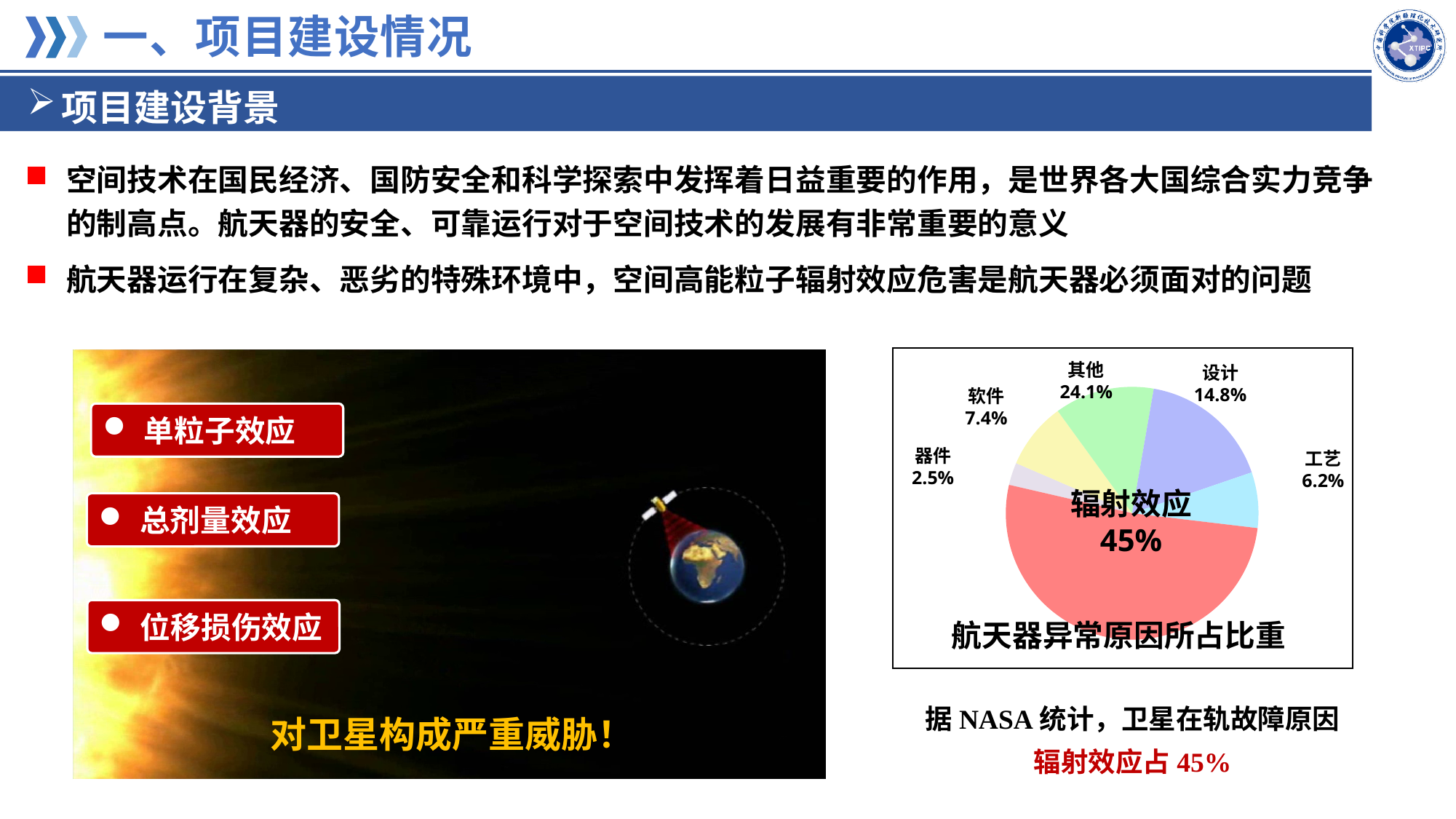
How many slices does the pie chart have? 6 Which is larger in the pie chart, 设计 or 工艺? 设计 What is the value shown for 其他 in the pie chart? 24.1% Which category has the smallest slice in the pie chart? 器件 What is the value shown for 软件 in the pie chart? 7.4% What share of the pie does 辐射效应 account for? 45% What is the value shown for 工艺 in the pie chart? 6.2% What kind of chart is shown on the slide? pie chart What is the title of the pie chart? 航天器异常原因所占比重 What is the difference between the shares of 辐射效应 and 其他? 20.9% Which category has the largest slice in the pie chart? 辐射效应 What is the value shown for 设计 in the pie chart? 14.8%